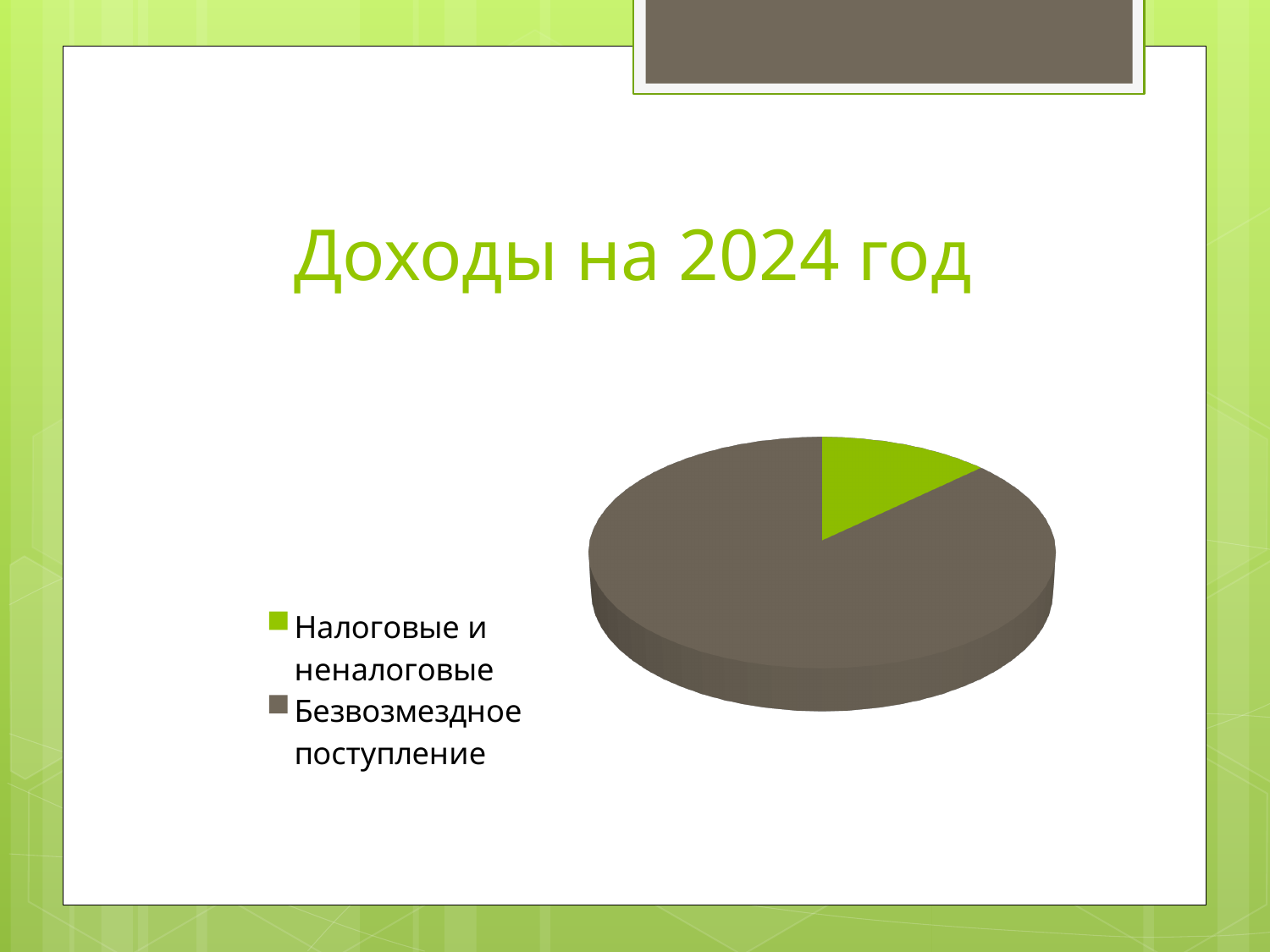
Which category has the smallest slice of the pie chart? Налоговые и неналоговые What is the title of the slide with the pie chart? Доходы на 2024 год Which is larger in the pie chart: Налоговые и неналоговые or Безвозмездное поступление? Безвозмездное поступление Which category has the largest slice of the pie chart? Безвозмездное поступление How many slices does the pie chart have? 2 What colour is the slice for Налоговые и неналоговые in the pie chart? green How many entries does the legend of the pie chart list? 2 What kind of chart is shown on the slide? pie chart